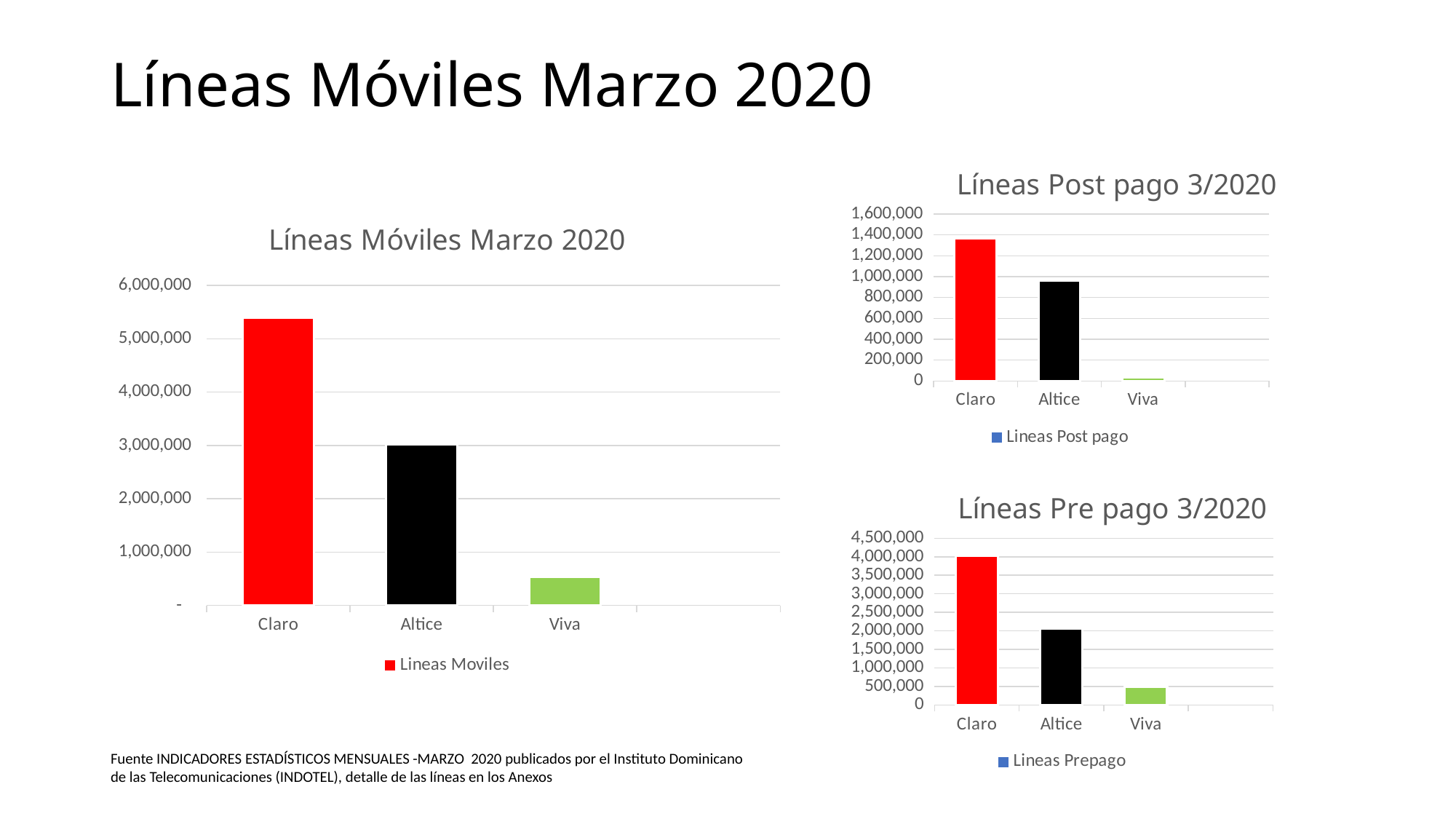
In the 'Líneas Móviles Marzo 2020' chart, which category has the highest value? Claro What kind of chart is 'Líneas Post pago 3/2020'? bar chart In the 'Líneas Móviles Marzo 2020' chart, is the value for Viva greater or less than 1,000,000? less In the 'Líneas Post pago 3/2020' chart, which category has the lowest value? Viva How many series does the legend of the 'Líneas Pre pago 3/2020' chart list? 1 In the 'Líneas Post pago 3/2020' chart, is the value for Claro greater or less than 1,200,000? greater In the 'Líneas Pre pago 3/2020' chart, which is larger, the value for Altice or the value for Viva? Altice In the 'Líneas Post pago 3/2020' chart, is the value for Altice greater or less than 800,000? greater In the 'Líneas Móviles Marzo 2020' chart, which category has the lowest value? Viva In the 'Líneas Móviles Marzo 2020' chart, how many categories are shown on the x axis? 3